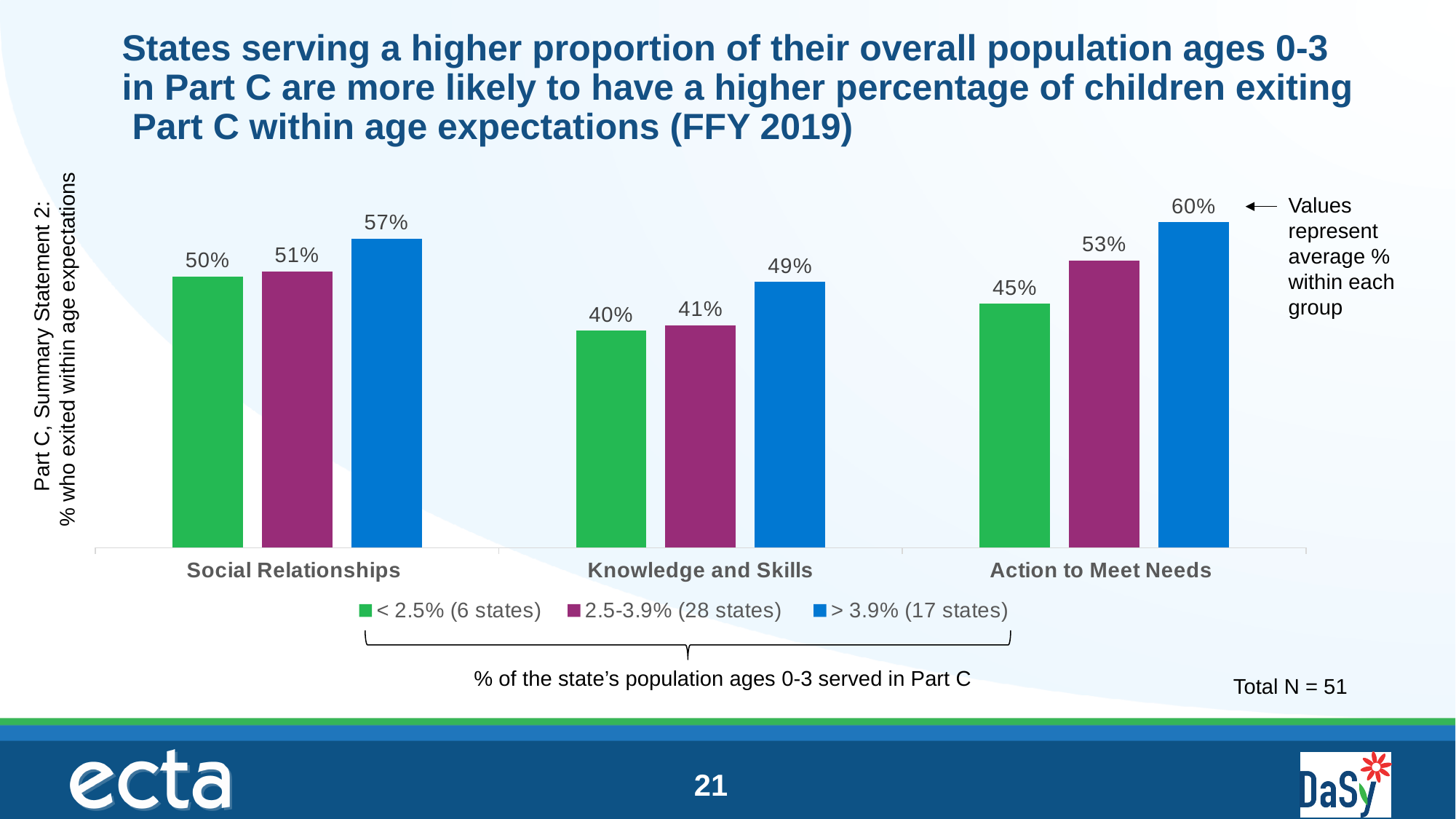
What is the value for the < 2.5% (6 states) group in the Knowledge and Skills category? 40% How many series does the legend list? 3 What is the difference between the > 3.9% (17 states) and < 2.5% (6 states) values in the Action to Meet Needs category? 15% What is the value for the 2.5-3.9% (28 states) group in the Action to Meet Needs category? 53% Within the Social Relationships category, do the values rise or fall from the < 2.5% group to the > 3.9% group? Rise Which category has the lowest value for the < 2.5% (6 states) group? Knowledge and Skills What kind of chart is shown on the slide? Bar chart Which category has the highest value for the > 3.9% (17 states) group? Action to Meet Needs How many categories are shown on the x axis? 3 In the Knowledge and Skills category, which is larger: the > 3.9% (17 states) value or the 2.5-3.9% (28 states) value? > 3.9% (17 states) What is the value for the > 3.9% (17 states) group in the Social Relationships category? 57% What colour represents the 2.5-3.9% (28 states) group? Purple